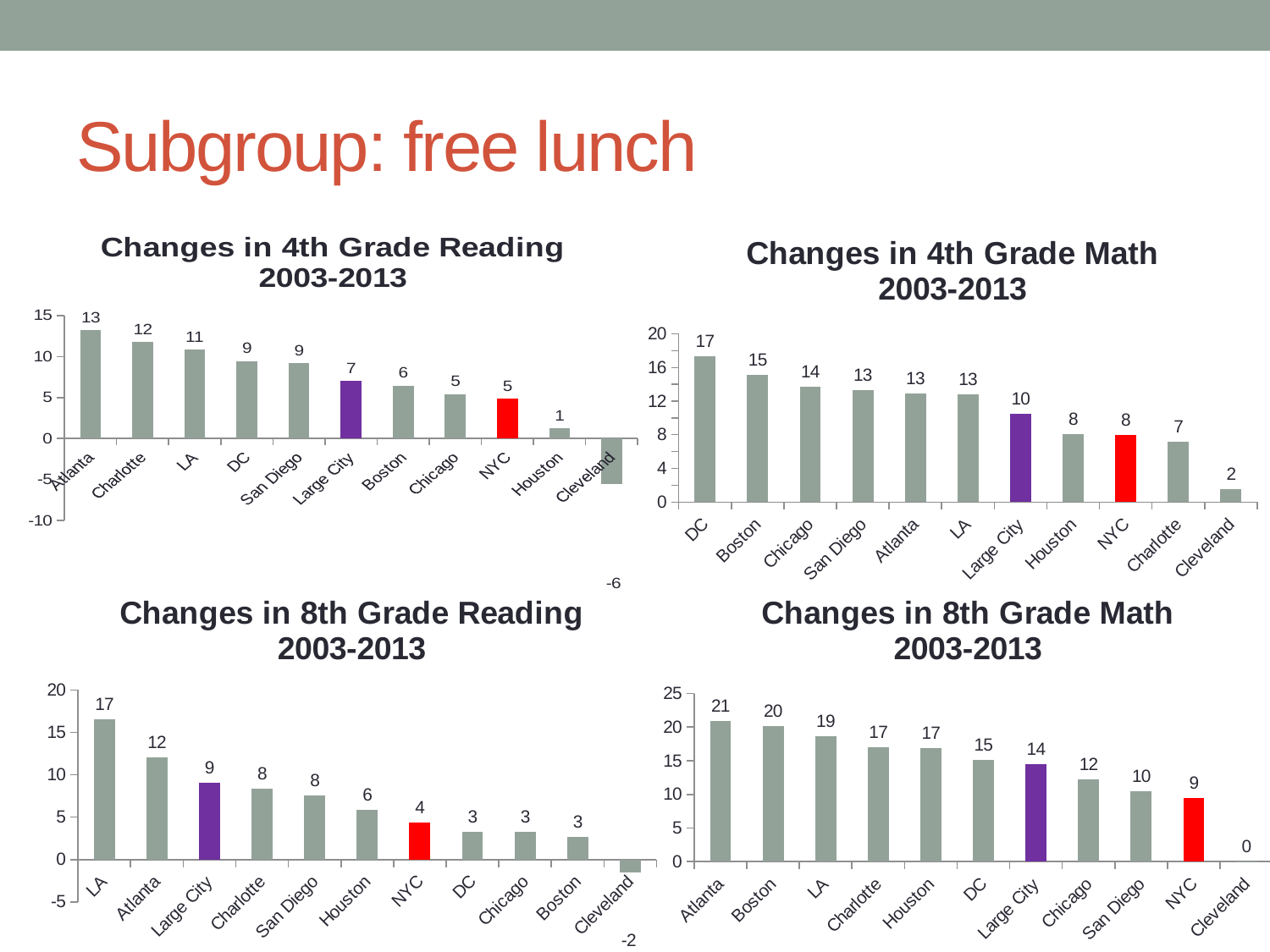
In the 'Changes in 8th Grade Reading 2003-2013' chart, what is the value for NYC? 4 In the 'Changes in 8th Grade Math 2003-2013' chart, what is the difference between Atlanta and NYC? 12 In the 'Changes in 4th Grade Math 2003-2013' chart, which city has the highest value? DC In the 'Changes in 8th Grade Reading 2003-2013' chart, how many cities are shown on the x axis? 11 In the 'Changes in 4th Grade Reading 2003-2013' chart, what is the value for Atlanta? 13 What type of chart is the 'Changes in 8th Grade Math 2003-2013' chart? Bar chart In the 'Changes in 4th Grade Reading 2003-2013' chart, which city has the lowest value? Cleveland In the 'Changes in 8th Grade Math 2003-2013' chart, what is the value for Boston? 20 In the 'Changes in 8th Grade Reading 2003-2013' chart, which is larger, LA or Atlanta? LA In the 'Changes in 4th Grade Math 2003-2013' chart, what is the difference between DC and Cleveland? 15 In the 'Changes in 4th Grade Reading 2003-2013' chart, what is the value for Cleveland? -6 In the 'Changes in 4th Grade Math 2003-2013' chart, what is the value for Large City? 10